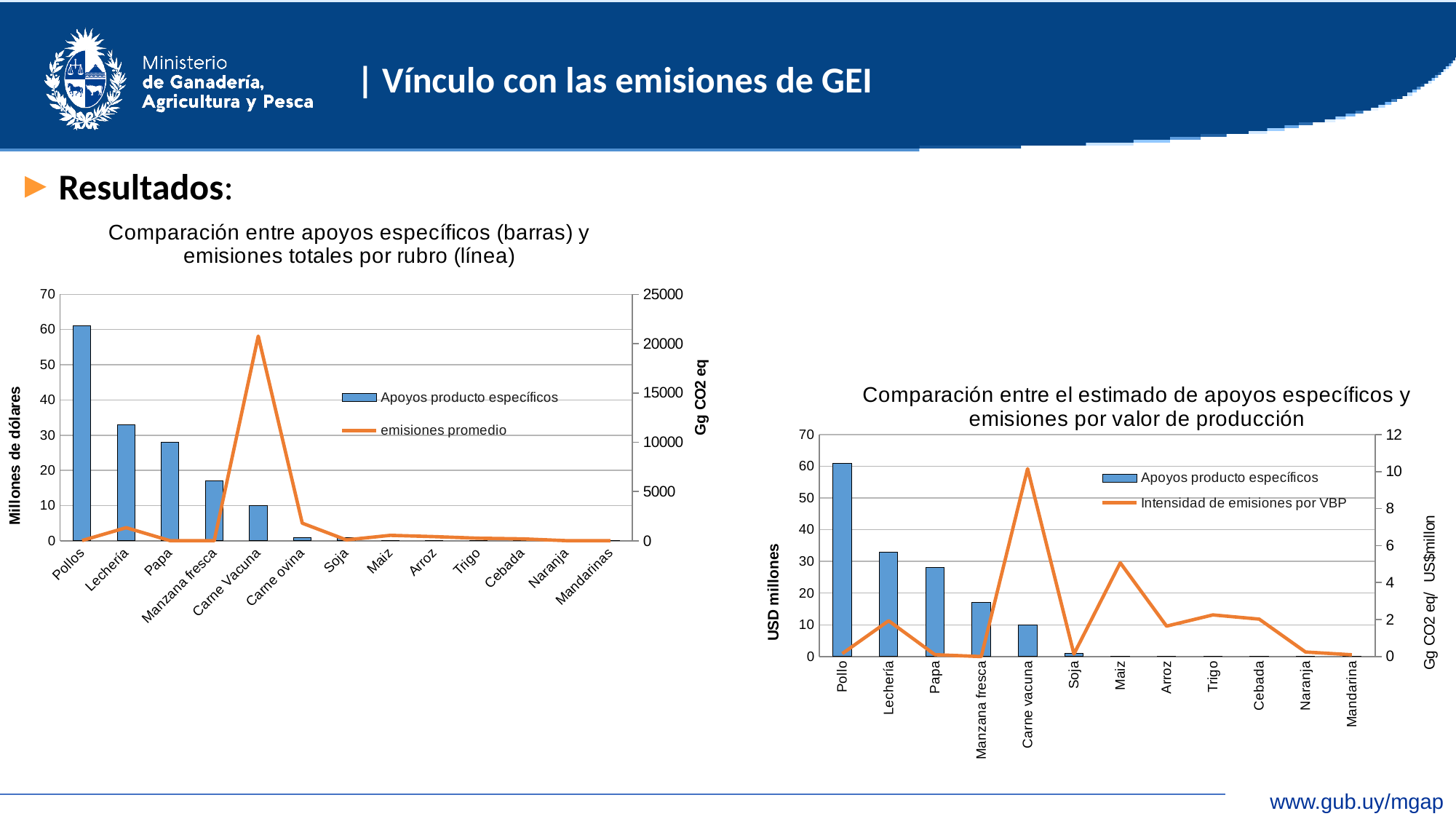
How many categories are shown on the x axis of the right chart (Comparación entre el estimado de apoyos específicos y emisiones por valor de producción)? 12 In the right chart, at which category does the Intensidad de emisiones por VBP line reach its highest point? Carne vacuna In the left chart, is the bar value for Pollos greater or less than 50? greater In the left chart, is the emisiones promedio value for Carne Vacuna greater or less than 15000? greater In the left chart, which has the taller bar, Lechería or Papa? Lechería What is the label of the right-hand vertical axis of the left chart? Gg CO2 eq In the left chart, at which category does the emisiones promedio line reach its peak? Carne Vacuna What kind of chart is the right chart? A combination of a bar chart and a line chart In the left chart (Comparación entre apoyos específicos (barras) y emisiones totales por rubro (línea)), which category has the tallest bar? Pollos How many categories are shown on the x axis of the left chart? 13 How many series does the legend of the left chart list? 2 In the right chart, is the Intensidad de emisiones por VBP value for Carne vacuna greater or less than 8? greater